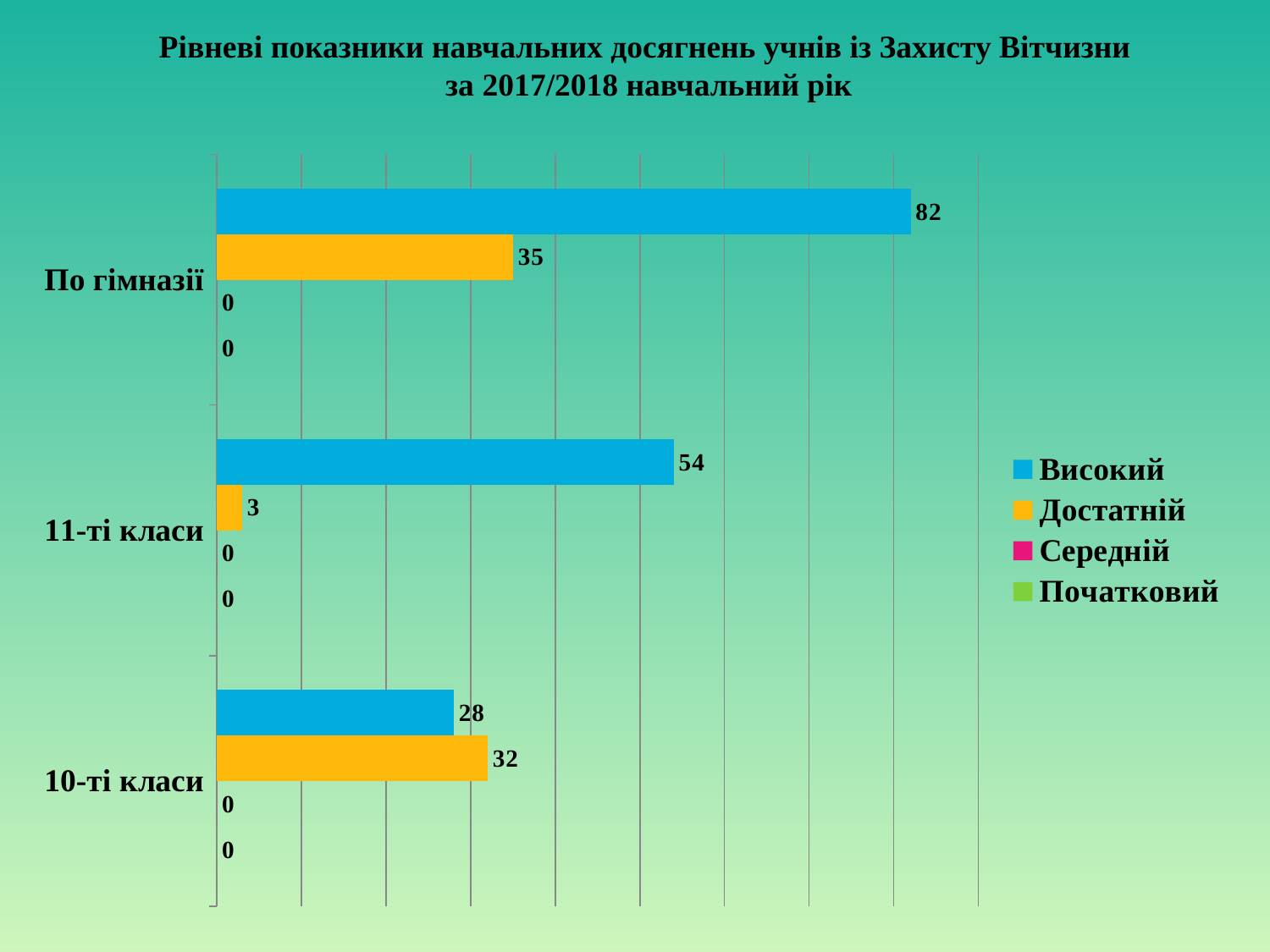
What kind of chart is shown on the slide? Bar chart What is the value of Достатній for 10-ті класи? 32 How many series does the legend list? 4 For 10-ті класи, which is larger: Високий or Достатній? Достатній What colour represents the Достатній series? Orange Which category has the highest value for Високий? По гімназії What is the value of Достатній for 11-ті класи? 3 What is the value of Високий for 11-ті класи? 54 What is the difference between the Високий values for По гімназії and 11-ті класи? 28 How many categories are shown on the chart? 3 What is the value of Високий for По гімназії? 82 Which category has the lowest value for Достатній? 11-ті класи